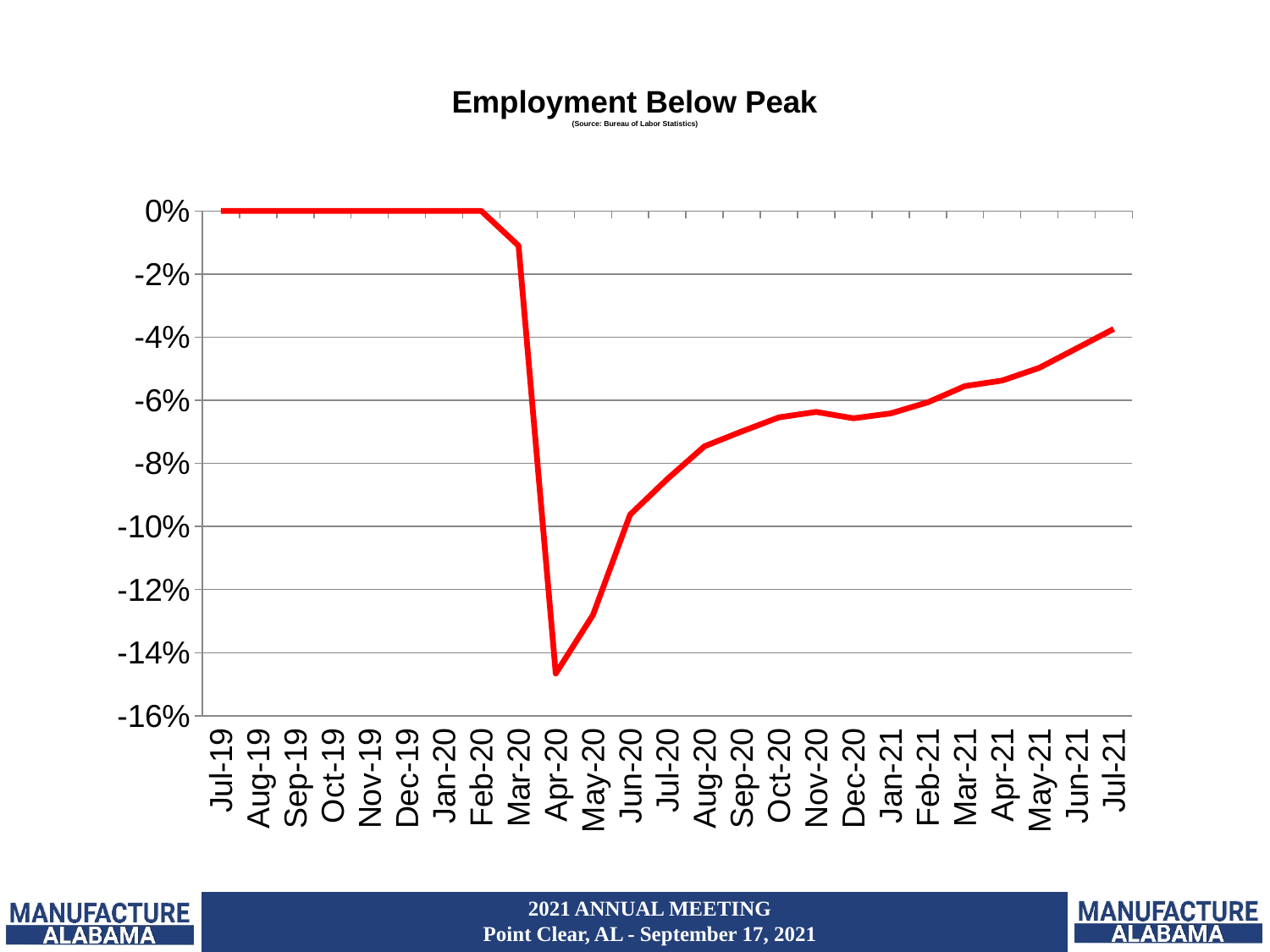
Is the value for Jul-21 greater or less than -4%? greater Is the value for Apr-20 greater or less than -14%? less What source is cited under the chart title? Bureau of Labor Statistics How many months are plotted along the x axis? 25 Which month has the lowest value on the chart? Apr-20 What kind of chart is shown on the slide? line chart What is the value for Feb-20? 0% Do the values rise or fall from Apr-20 to Jul-21? rise Which is larger, the value for Apr-20 or the value for May-20? May-20 What is the value for Jul-19? 0% What is the title of the chart? Employment Below Peak Is the value for Jun-20 greater or less than -8%? less